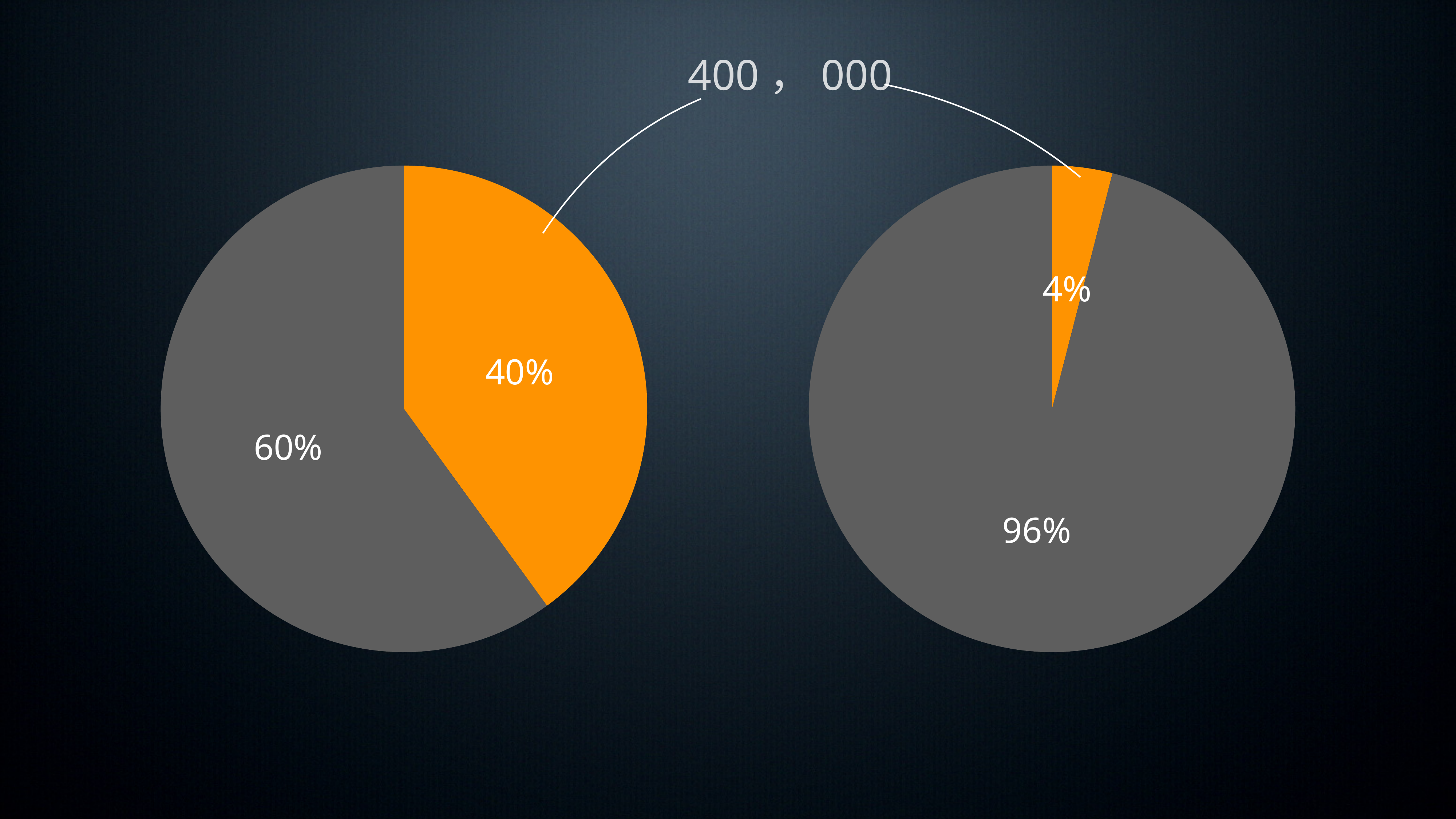
What kind of chart is the chart on the left of the slide? pie chart What kind of chart is the chart on the right of the slide? pie chart What number is written above the two pie charts, with lines pointing to the orange slices? 400,000 In the right pie chart, what share does the grey slice represent? 96% In the right pie chart, what share does the orange slice represent? 4% What is the difference between the orange slice's share in the left pie chart and the orange slice's share in the right pie chart? 36 percentage points In the left pie chart, which slice is larger, the orange one or the grey one? the grey one How many slices does the left pie chart have? 2 In the right pie chart, which slice is the smallest? the orange slice (4%) In the left pie chart, what share does the grey slice represent? 60% How many slices does the right pie chart have? 2